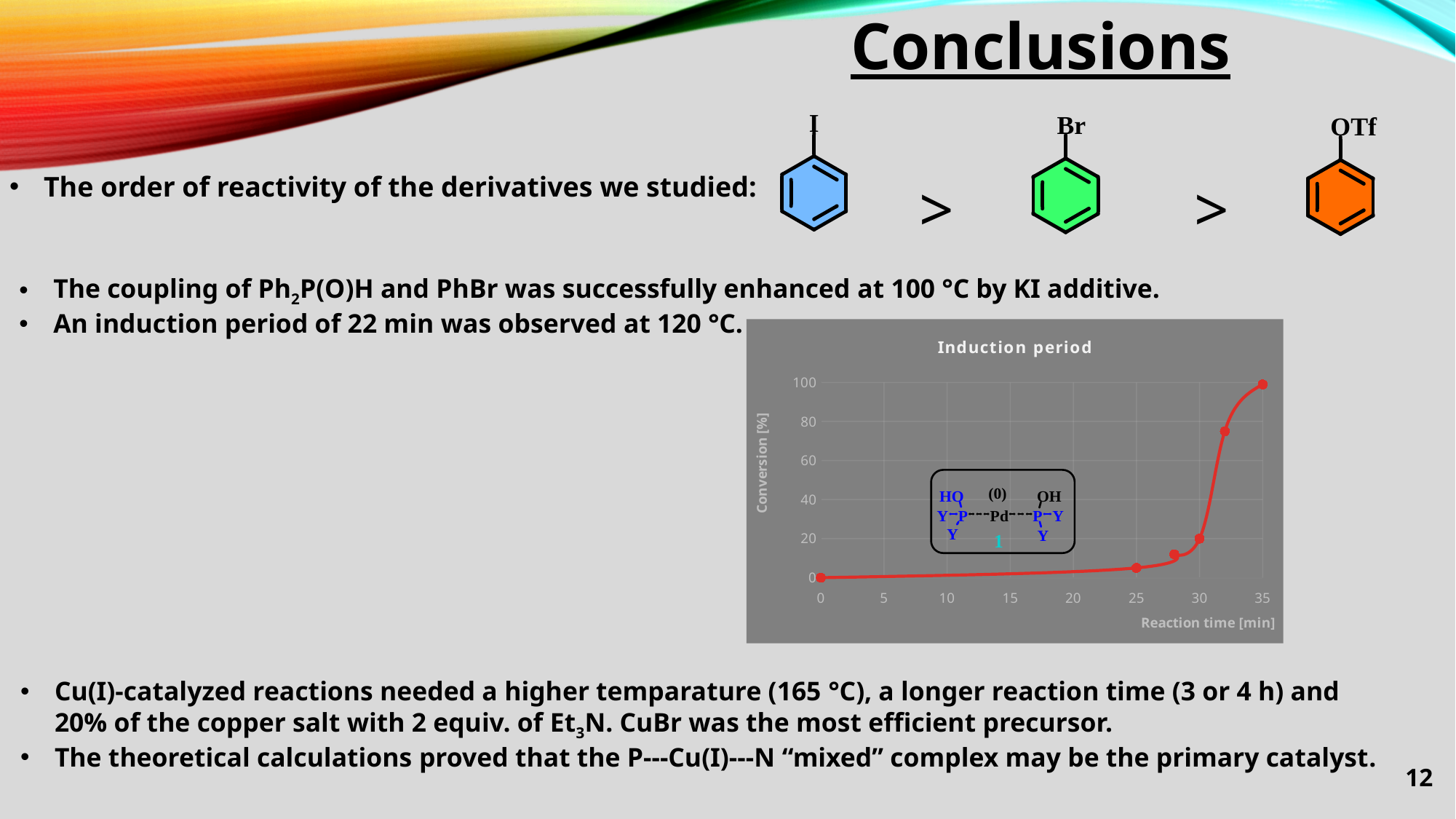
What is the label of the x axis of the chart? Reaction time [min] At which reaction time is the conversion lowest? 0 min What is the title of the chart? Induction period Is the conversion at 25 min greater or less than 20? less At which reaction time is the conversion highest? 35 min Is the conversion at 32 min greater or less than 60? greater Does the conversion rise or fall as reaction time increases? rises Which has the higher conversion, 28 min or 32 min? 32 min How many data points are plotted on the chart? 6 What kind of chart is shown on the slide? line chart Is the conversion at 30 min greater or less than 40? less